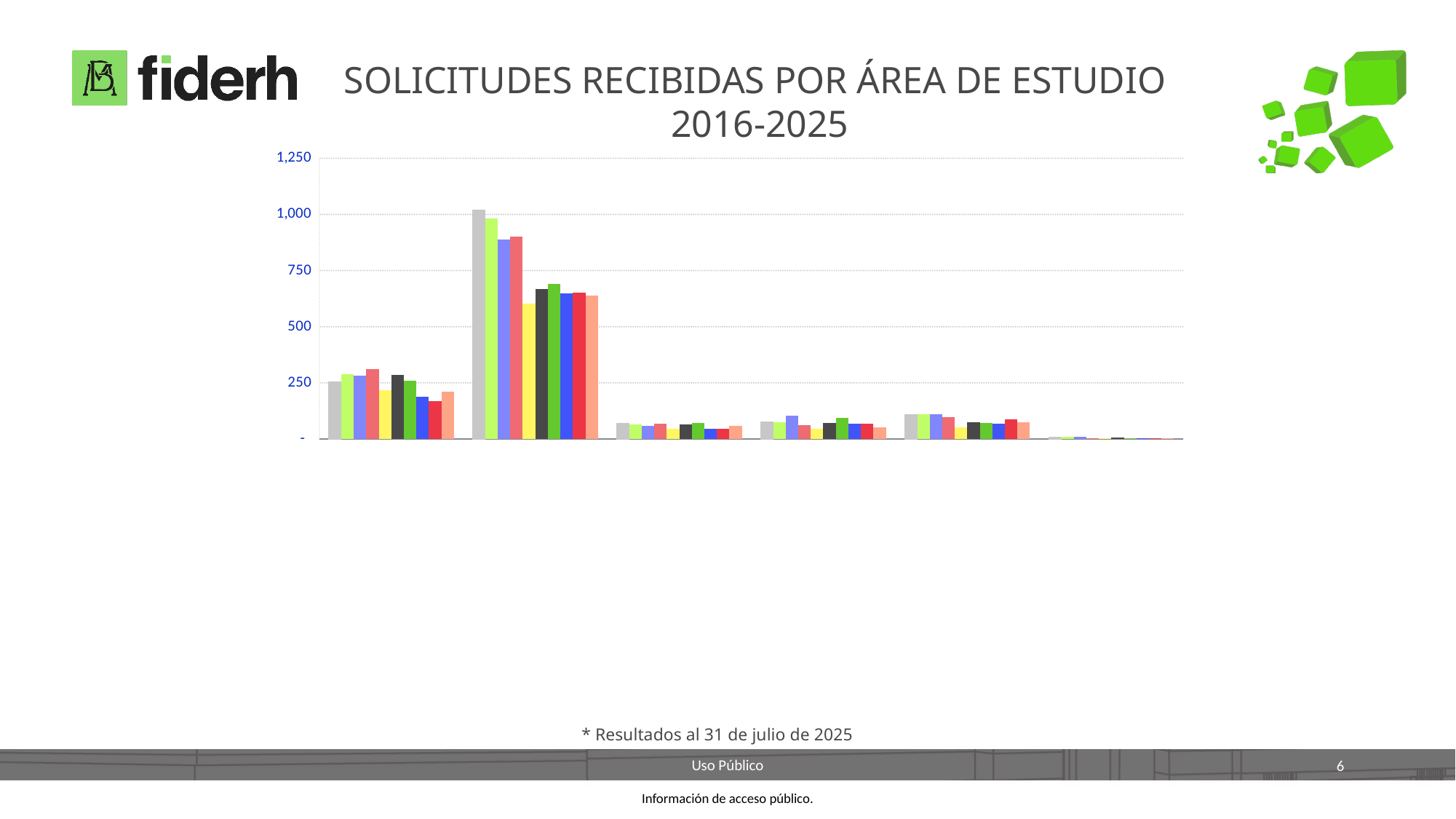
How many bars are there in each group of the chart? 10 Are all the bars in the third group from the left greater or less than 250? less Which group of bars, counted from the left, contains the tallest bar in the chart? the second group Is the tallest bar in the first (leftmost) group greater or less than 500? less How many groups of bars are plotted along the x axis of the chart? 6 Is the shortest bar in the second group from the left greater or less than 500? greater Which group of bars, counted from the left, has the lowest values in the chart? the sixth (rightmost) group What is the highest value shown on the vertical axis of the chart? 1,250 Which is larger: the tallest bar in the first group from the left or the tallest bar in the fifth group from the left? the first group What kind of chart is shown on the slide? bar chart What is the title of the chart on the slide? SOLICITUDES RECIBIDAS POR ÁREA DE ESTUDIO 2016-2025